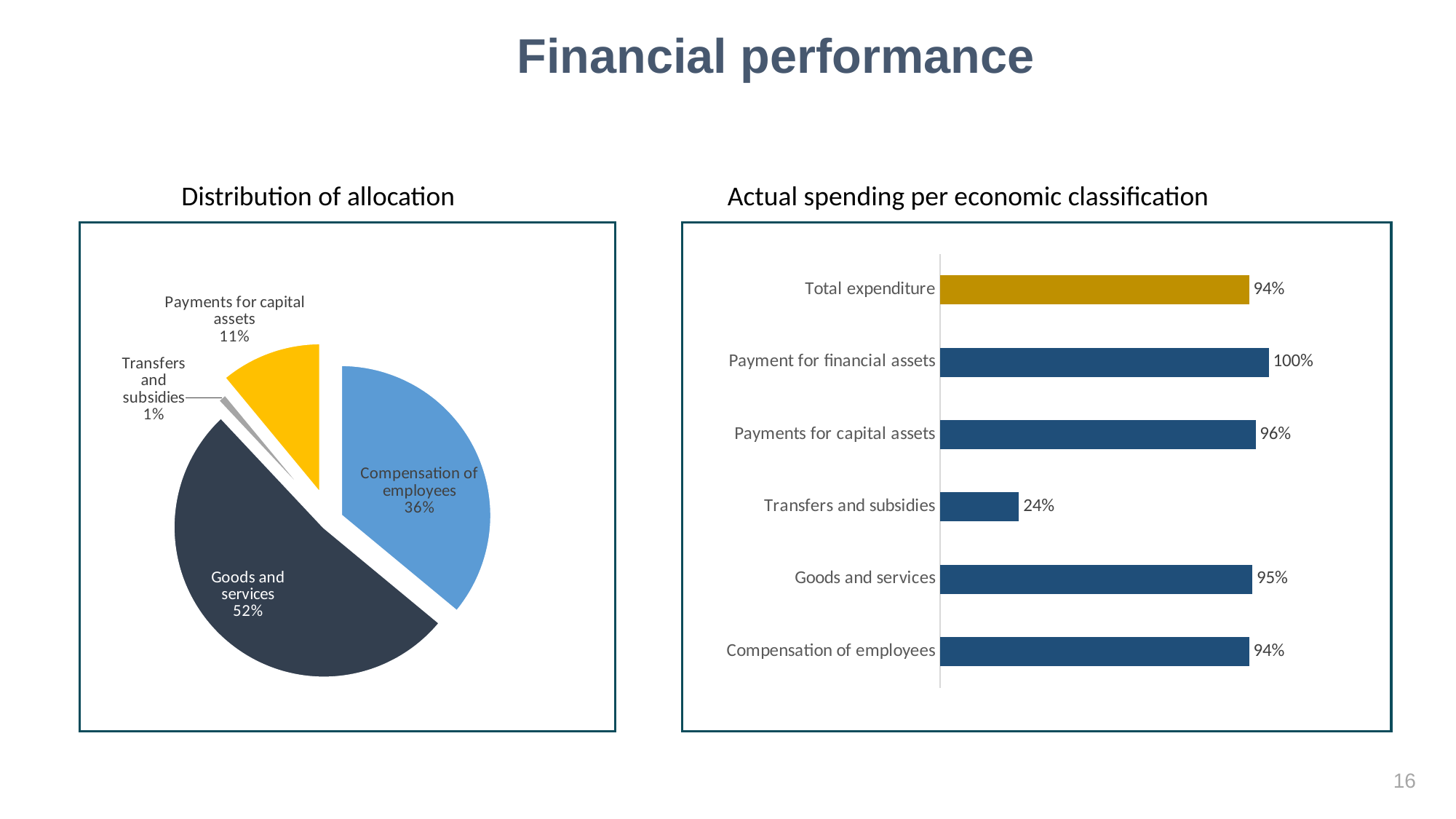
In the 'Distribution of allocation' chart, how many slices does the pie have? 4 In the 'Actual spending per economic classification' chart, which category has the highest value? Payment for financial assets In the 'Actual spending per economic classification' chart, which bar is shown in a different colour from the others? Total expenditure In the 'Distribution of allocation' chart, what share of the allocation goes to Goods and services? 52% In the 'Distribution of allocation' chart, which category has the smallest slice? Transfers and subsidies In the 'Distribution of allocation' chart, what is the difference between the Goods and services share and the Compensation of employees share? 16% In the 'Actual spending per economic classification' chart, what is the value for Transfers and subsidies? 24% In the 'Actual spending per economic classification' chart, which category has the lowest value? Transfers and subsidies In the 'Distribution of allocation' chart, what percentage is shown for Compensation of employees? 36% In the 'Actual spending per economic classification' chart, how many categories are shown? 6 What kind of chart is 'Actual spending per economic classification'? Bar chart In the 'Distribution of allocation' chart, which category has the largest slice? Goods and services